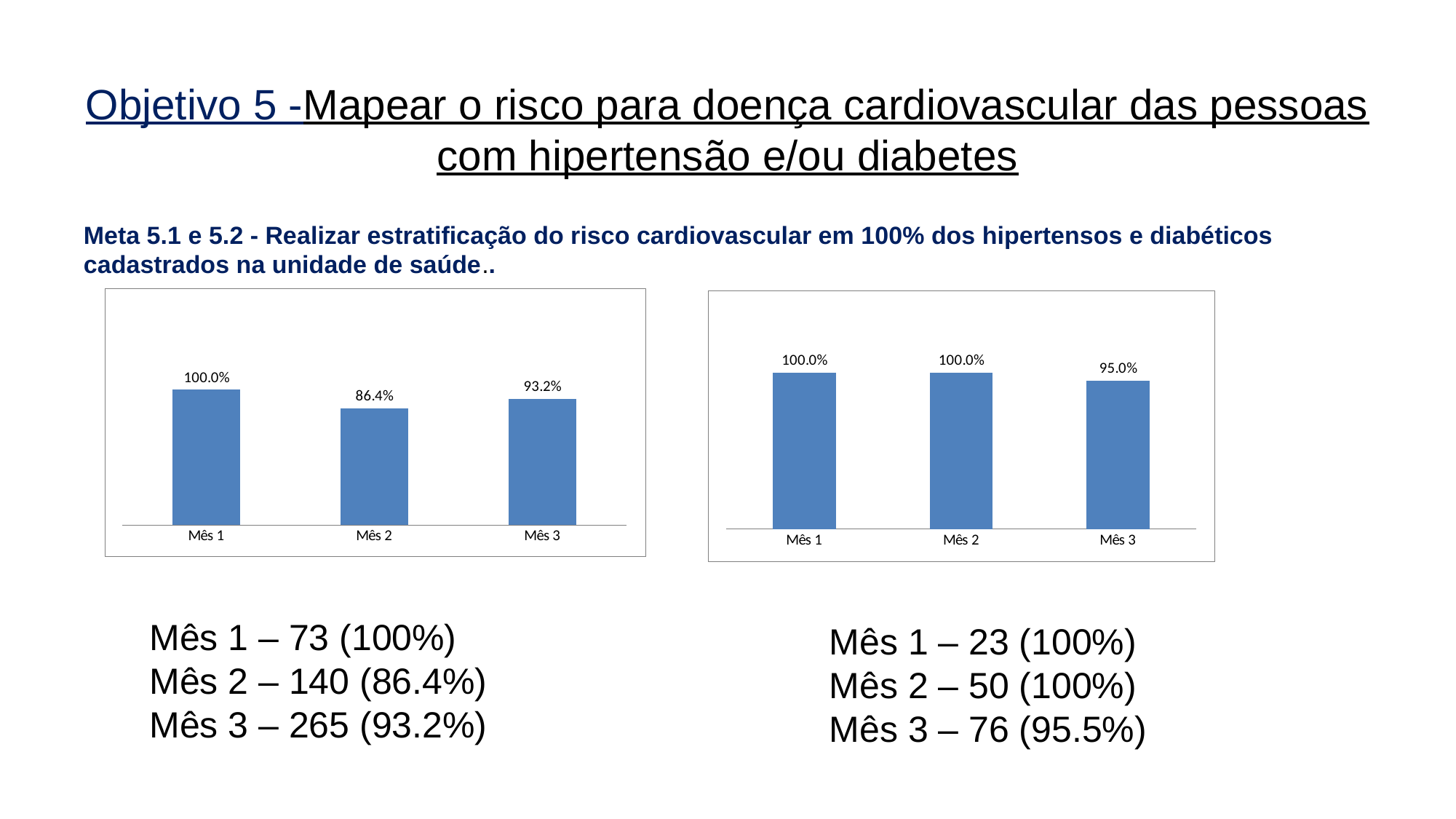
In the left chart, what is the value for Mês 2? 86.4% In the right chart, what is the difference between the values for Mês 2 and Mês 3? 5.0% In the left chart, what is the value for Mês 3? 93.2% In the right chart, what is the value for Mês 1? 100.0% In the left chart, which month has the lowest value? Mês 2 In the left chart, what is the difference between the values for Mês 1 and Mês 2? 13.6% How many bars are plotted in the right chart? 3 In the left chart, which is larger, the value for Mês 2 or Mês 3? Mês 3 In the right chart, what is the value for Mês 3? 95.0% In the left chart, which month has the highest value? Mês 1 What type of chart is the left chart? Bar chart In the right chart, which month has the lowest value? Mês 3